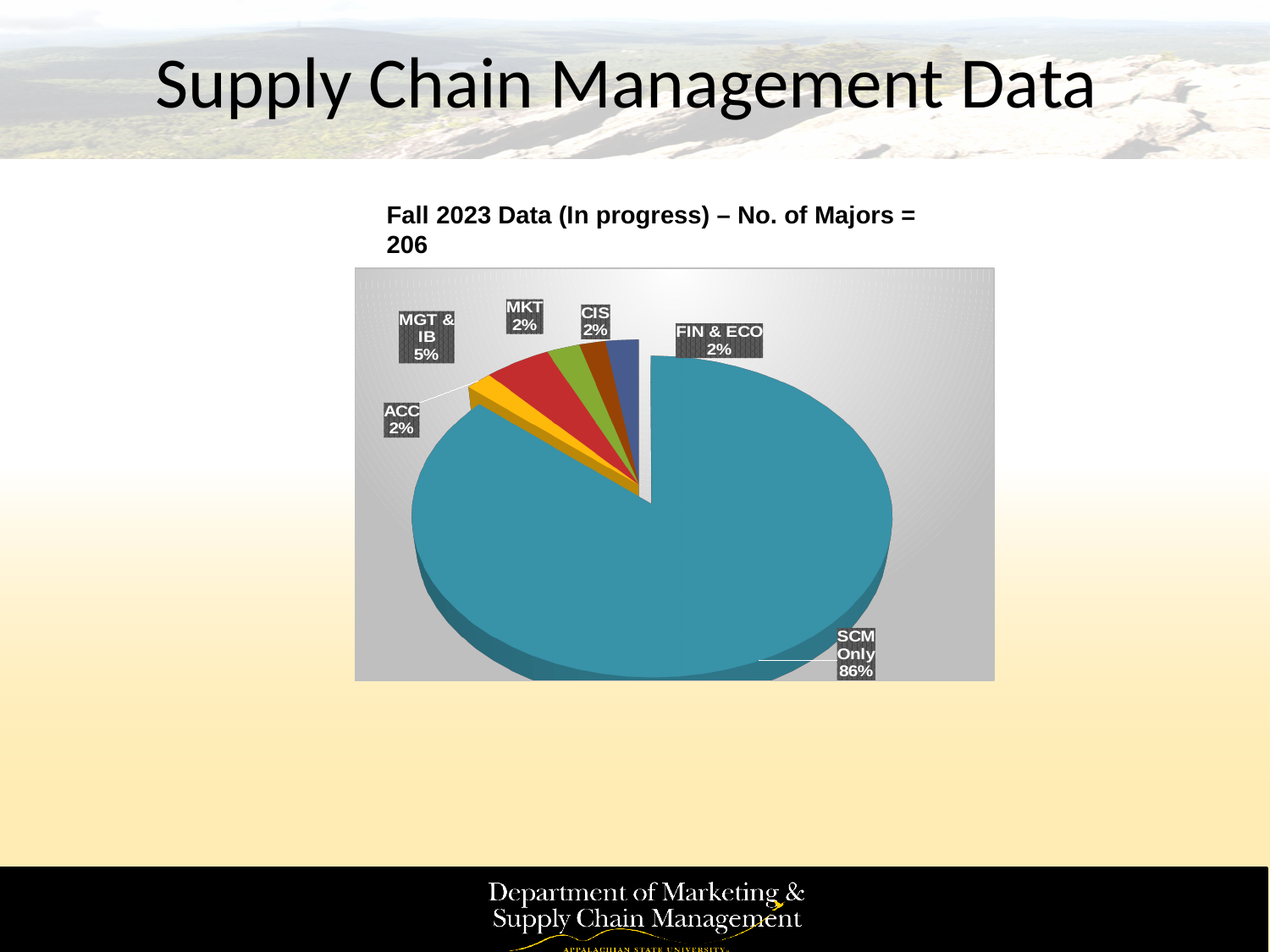
What is the difference in percentage points between the SCM Only share and the MGT & IB share? 81% What kind of chart is shown on the slide? pie chart What share of the pie does MGT & IB represent? 5% According to the chart heading, what is the total number of majors? 206 Which is larger, the share for MGT & IB or the share for MKT? MGT & IB Which slice of the pie is the largest? SCM Only Which semester does the chart heading say the data is for? Fall 2023 What is the difference in percentage points between the MGT & IB share and the CIS share? 3% What share of the pie does FIN & ECO represent? 2% How many slices does the pie chart have? 6 What share of the pie does SCM Only represent? 86% What share of the pie does ACC represent? 2%